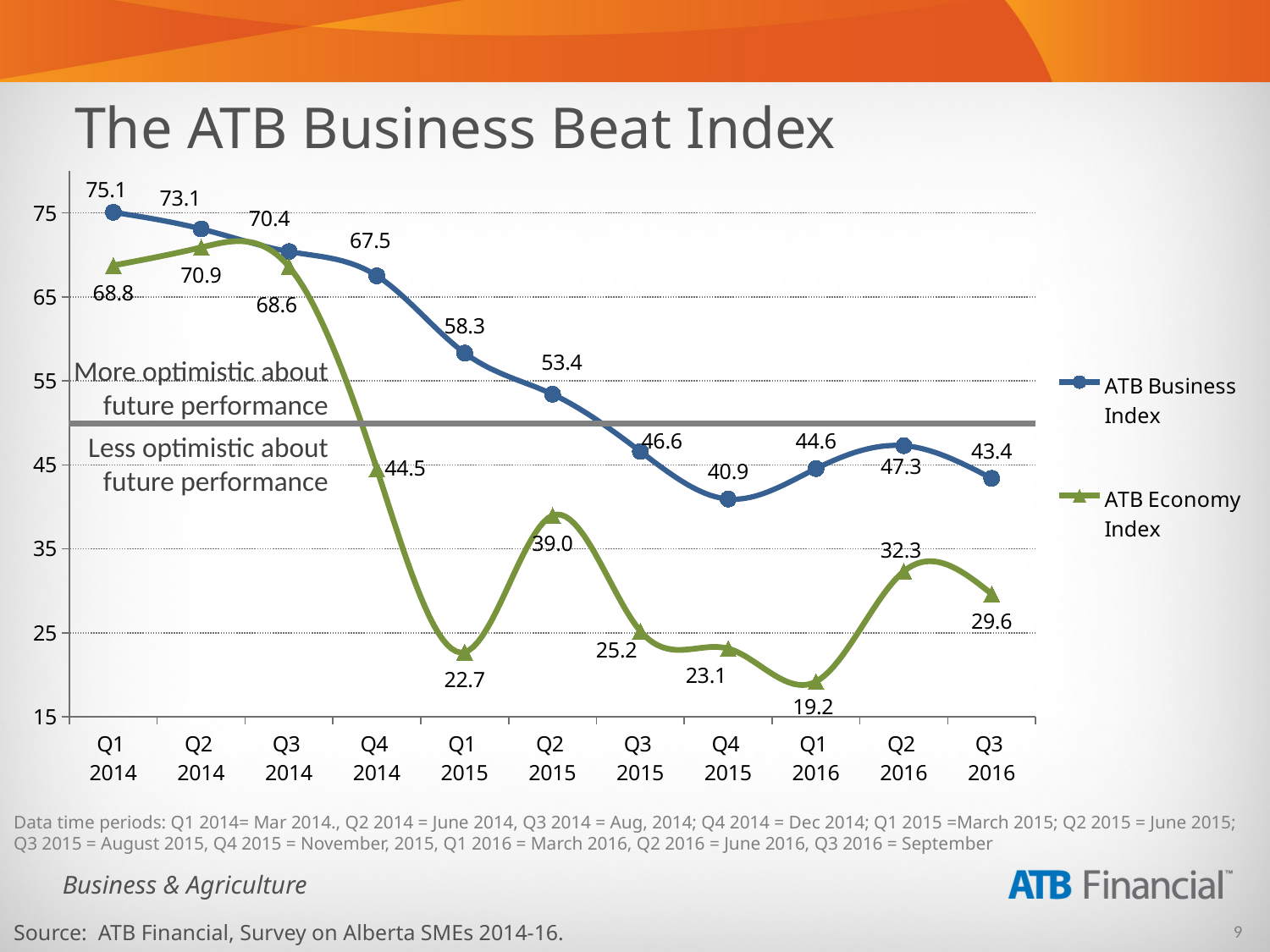
What is the title of the chart? The ATB Business Beat Index In which period is the ATB Business Index lowest? Q4 2015 In which period is the ATB Economy Index highest? Q2 2014 How many series does the legend list? 2 Does the ATB Business Index generally rise or fall from Q1 2014 to Q4 2015? fall What is the value of the ATB Business Index in Q1 2014? 75.1 Which series has the higher value in Q4 2014, the ATB Business Index or the ATB Economy Index? ATB Business Index What is the value of the ATB Economy Index in Q1 2016? 19.2 What is the value of the ATB Economy Index in Q2 2015? 39.0 What type of chart is shown on the slide? line chart What is the difference between the ATB Business Index and the ATB Economy Index in Q3 2016? 13.8 How many time periods are plotted along the x axis? 11